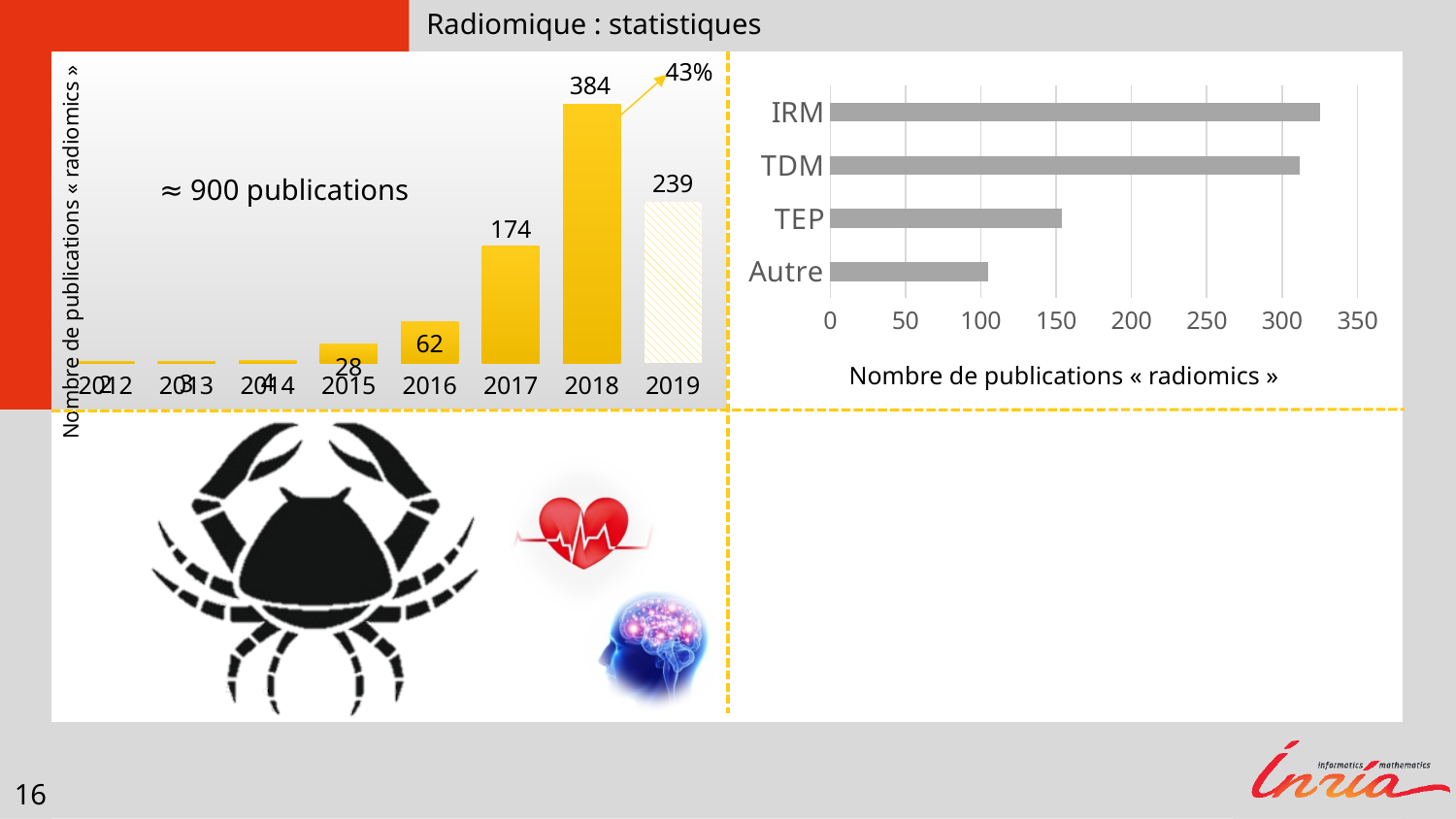
In the left chart (publications per year), what is the value for 2016? 62 In the left chart (publications per year), how many years are shown on the x axis? 8 In the left chart (publications per year), do the values rise or fall from 2015 to 2018? rise In the left chart (publications per year), what is the value for 2017? 174 In the left chart (publications per year), what is the difference between the 2018 and 2017 values? 210 In the left chart (publications per year), which is larger, the value for 2019 or for 2017? 2019 In the left chart (publications per year), how many publications are shown for 2018? 384 In the right chart (publications by modality), is the value for TEP greater or less than 200? less In the left chart (publications per year), which year has the highest number of publications? 2018 In the right chart (publications by modality), which category has the lowest value? Autre In the left chart (publications per year), what is the value for 2019? 239 In the right chart (publications by modality), which category has the highest value? IRM